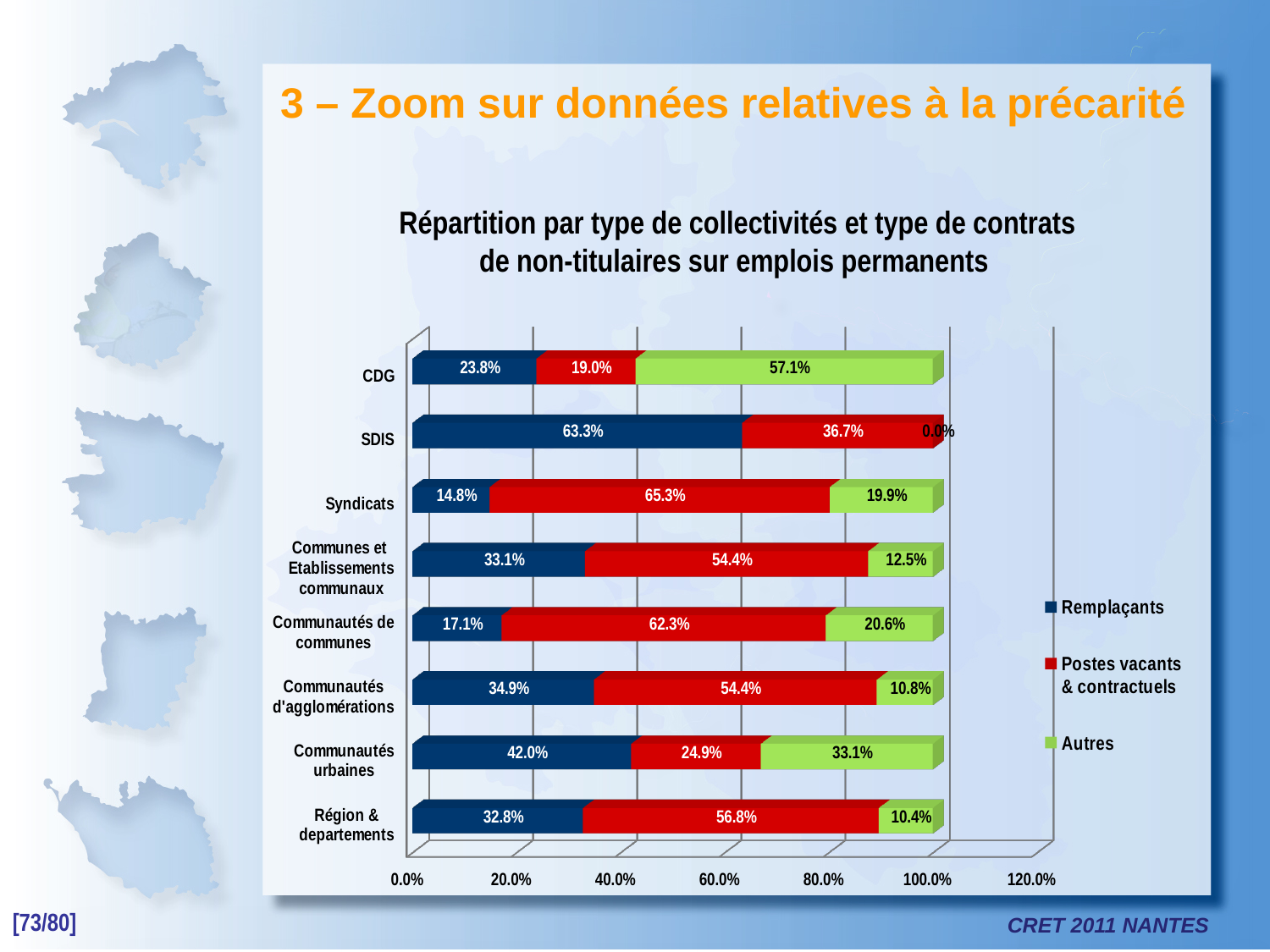
Which category has the highest Remplaçants value? SDIS What is the Remplaçants value for Communautés urbaines? 42.0% How many categories are shown on the chart? 8 What is the Postes vacants & contractuels value for Syndicats? 65.3% Which is larger for Communautés urbaines: the Remplaçants value or the Autres value? Remplaçants Which category has the lowest Autres value? SDIS How many series does the legend list? 3 What is the Remplaçants value for SDIS? 63.3% Which category has the lowest Remplaçants value? Syndicats What is the Autres value for CDG? 57.1% What is the difference between the Autres value and the Remplaçants value for CDG? 33.3 percentage points What kind of chart is shown on the slide? Stacked bar chart